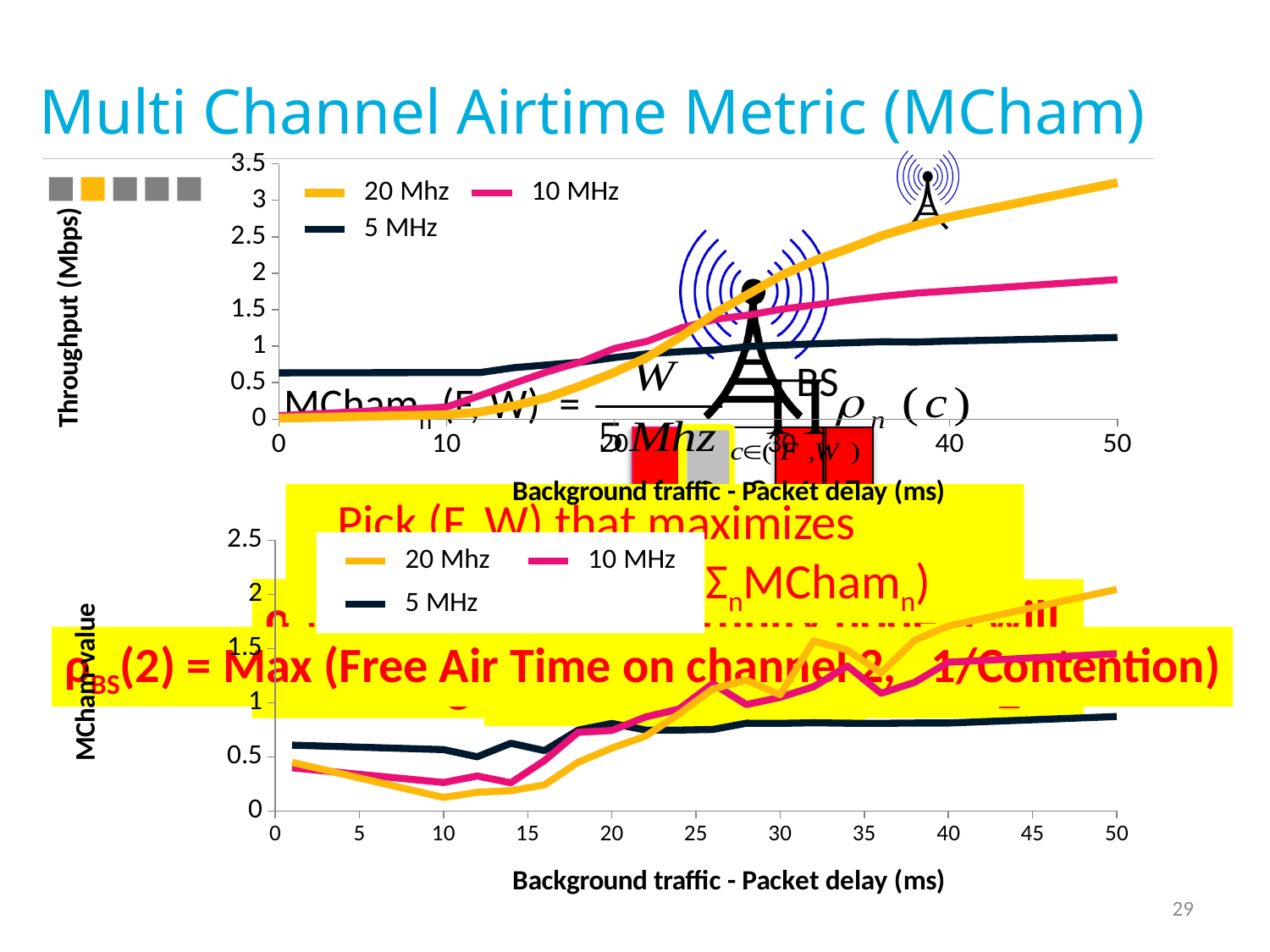
In the top chart (Throughput), does the 20 Mhz throughput rise or fall as packet delay increases from 0 to 50 ms? rise In the bottom chart (MCham-value), is the 20 Mhz value at 50 ms greater or less than 1.5? greater In the top chart (Throughput), which series has the lowest throughput at a packet delay of 50 ms? 5 MHz What kind of chart is the top chart on the slide (Throughput vs Background traffic)? line chart In the top chart (Throughput), is the 5 MHz throughput at 50 ms greater or less than 1.5? less How many series does the legend of the top chart (Throughput) list? 3 In the top chart (Throughput), which series is higher at a packet delay of 0 ms: 5 MHz or 20 Mhz? 5 MHz In the top chart (Throughput), which series has the highest throughput at a packet delay of 50 ms? 20 Mhz In the bottom chart (MCham-value), which series has the highest value at a packet delay of 50 ms? 20 Mhz In the bottom chart (MCham-value), which series is higher at a packet delay of 10 ms: 5 MHz or 20 Mhz? 5 MHz What is the x-axis label of the bottom chart (MCham-value)? Background traffic - Packet delay (ms) In the top chart (Throughput), is the 20 Mhz throughput at 50 ms greater or less than 3? greater